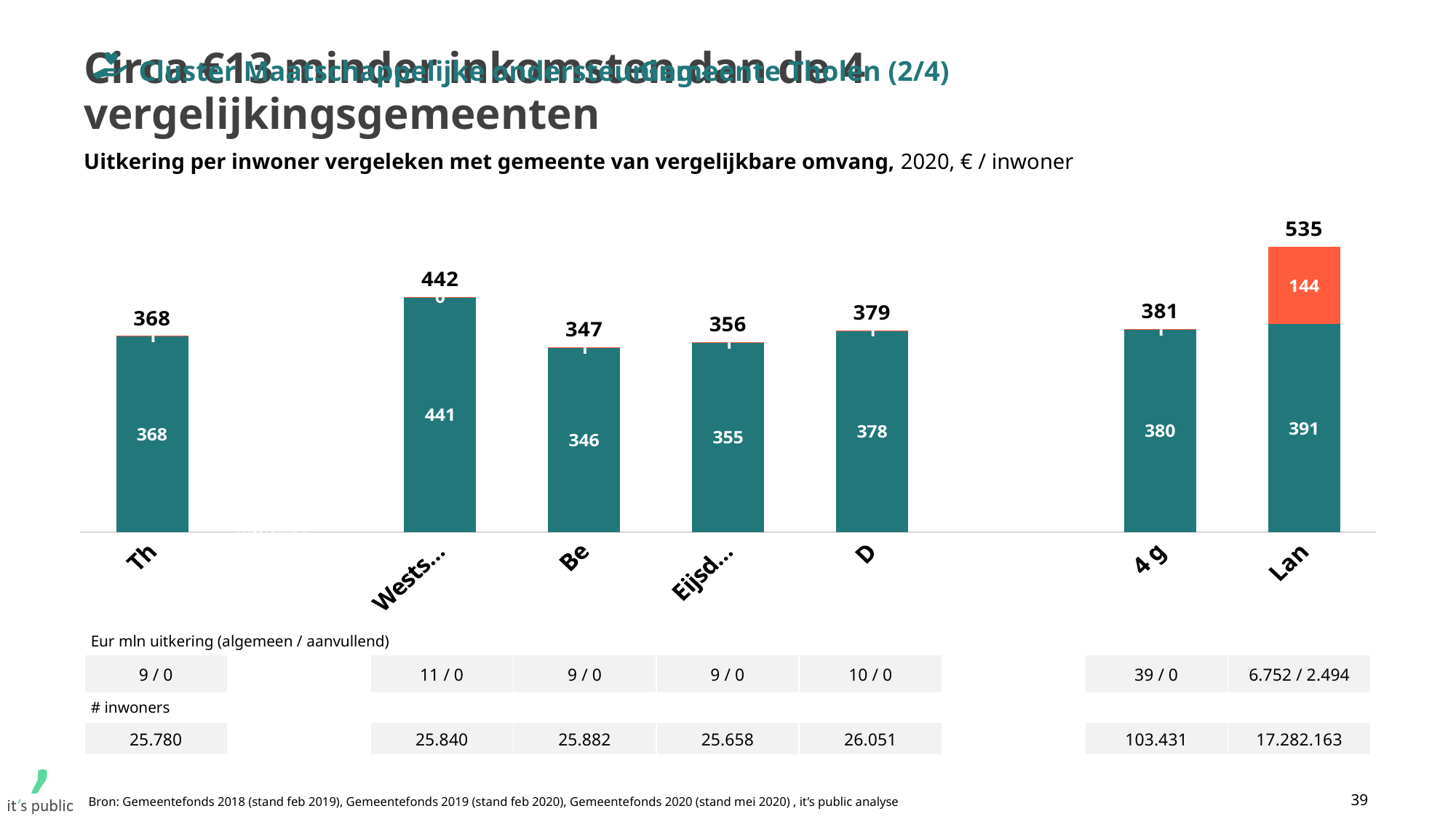
Which has a larger total value, "D" or "Eijsd..."? D What unit is stated in the chart subtitle for the plotted values? € / inwoner Which category has the highest total value? Lan What is the total value shown above the bar for "Lan"? 535 What is the difference between the total for "Lan" (535) and the total for "Th" (368)? 167 What is the sum of the two segments of the "Lan" bar (391 and 144)? 535 What is the value of the orange (top) segment of the "Lan" bar? 144 What is the total value shown above the bar for "Th"? 368 How many bars are shown in the chart? 7 Which category has the lowest total value? Be What kind of chart is shown on the slide? Stacked bar chart What is the value of the teal (bottom) segment of the "Wests..." bar? 441